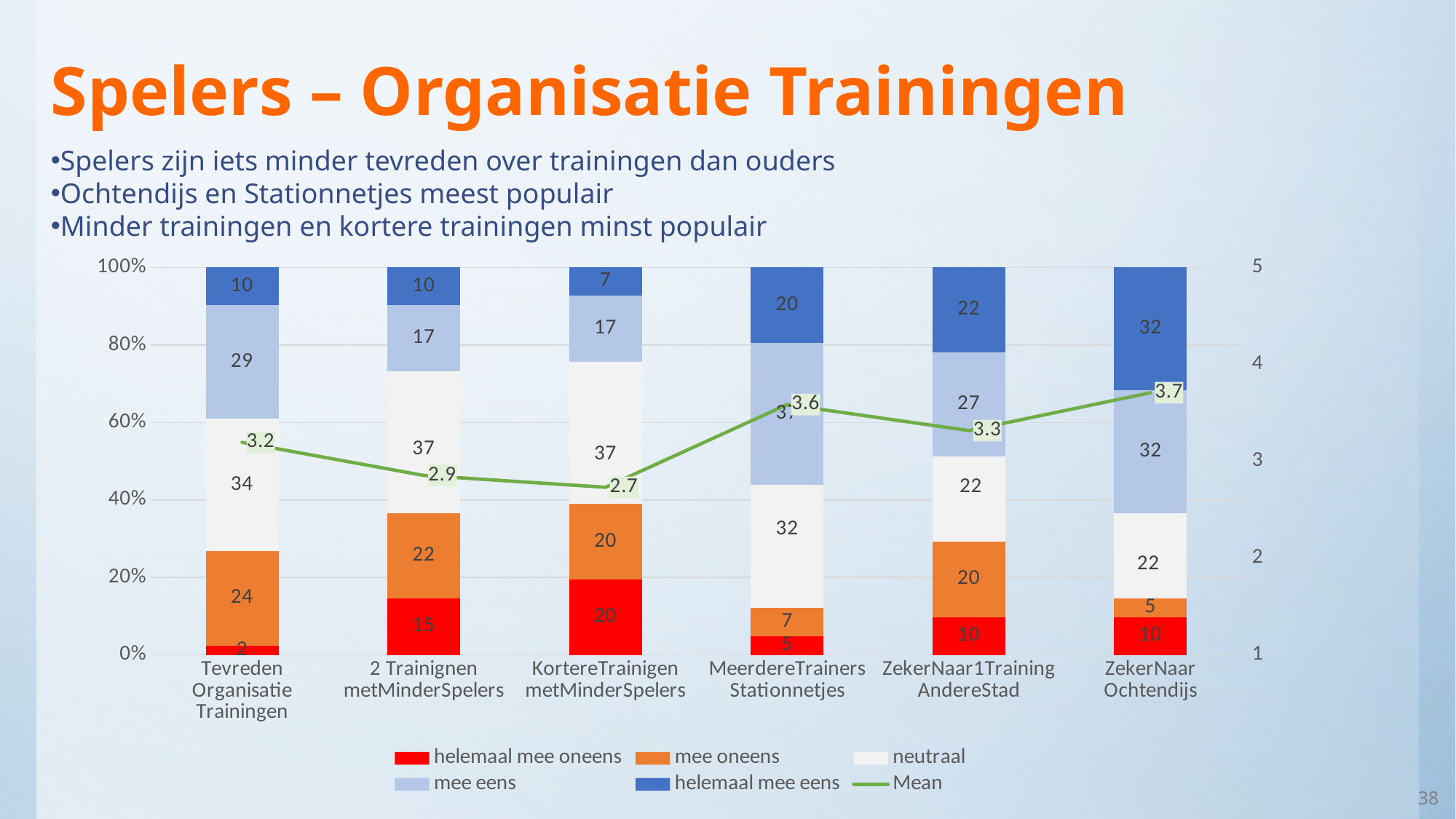
Which category has the lowest Mean value? KortereTrainigen metMinderSpelers What is the Mean value for ZekerNaar Ochtendijs? 3.7 How many categories are shown on the x axis? 6 What is the Mean value for 2 Trainignen metMinderSpelers? 2.9 What is the difference between the 'helemaal mee eens' values for ZekerNaar Ochtendijs and KortereTrainigen metMinderSpelers? 25 Which category has the highest Mean value? ZekerNaar Ochtendijs What is the 'neutraal' value for Tevreden Organisatie Trainingen? 34 What is the 'mee oneens' value for ZekerNaar1Training AndereStad? 20 How many series does the legend list? 6 Which has the larger 'helemaal mee oneens' value: 2 Trainignen metMinderSpelers or KortereTrainigen metMinderSpelers? KortereTrainigen metMinderSpelers What kind of chart is shown on the slide? Stacked bar chart with a line Which category has the highest 'helemaal mee oneens' value? KortereTrainigen metMinderSpelers